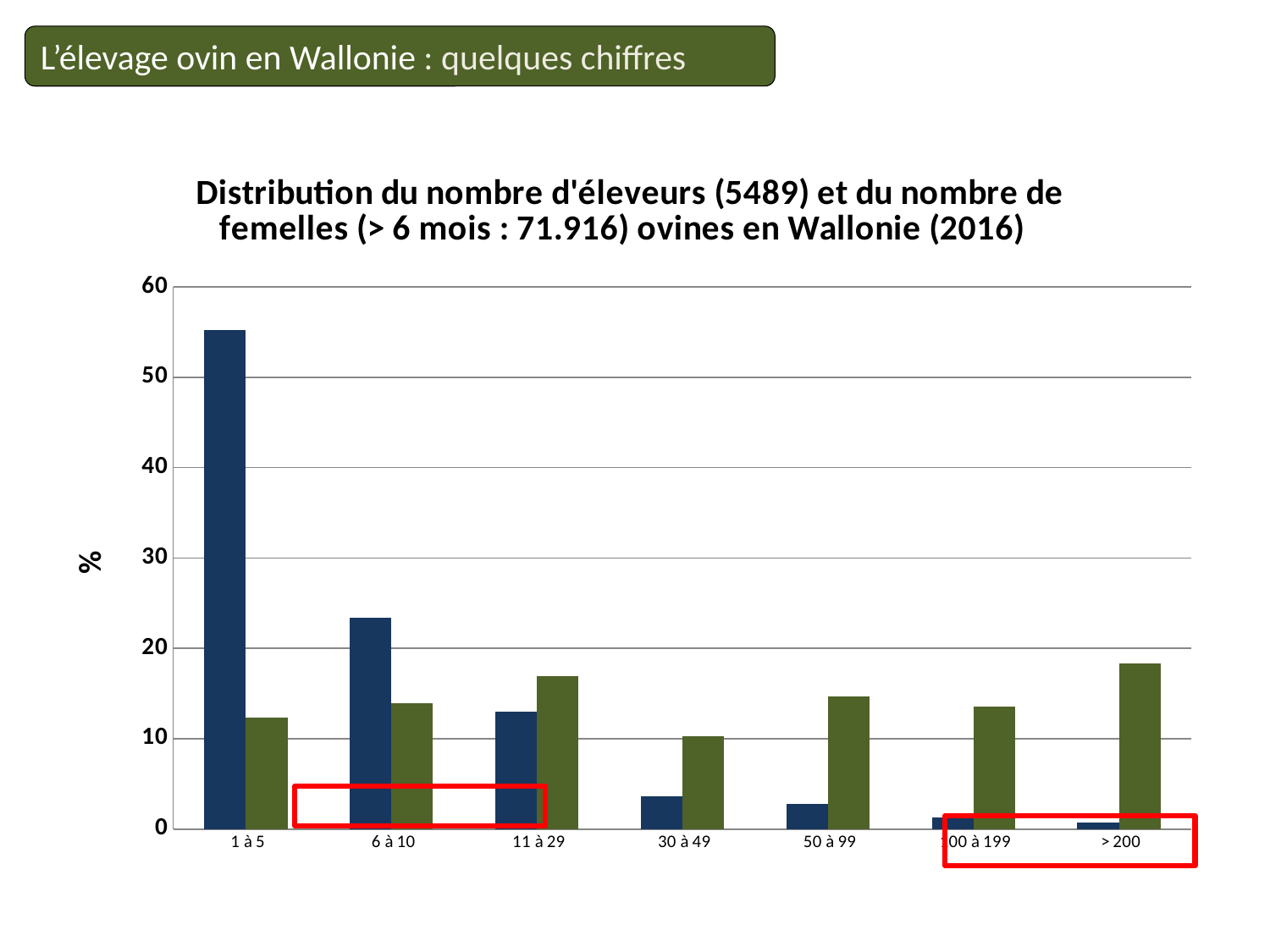
Which category has the highest dark blue bar? 1 à 5 Do the dark blue bars rise or fall from left to right along the x axis? fall What is the label on the vertical axis of the chart? % What kind of chart is shown on the slide? bar chart Is the dark blue bar for 30 à 49 greater or less than 10? less Which category has the lowest green bar? 30 à 49 Is the dark blue bar for 1 à 5 greater or less than 50? greater For the category 1 à 5, which bar is taller, the dark blue one or the green one? dark blue Is the dark blue bar for 6 à 10 greater or less than 20? greater For the category 50 à 99, which bar is taller, the dark blue one or the green one? green How many categories are shown along the x axis of the chart? 7